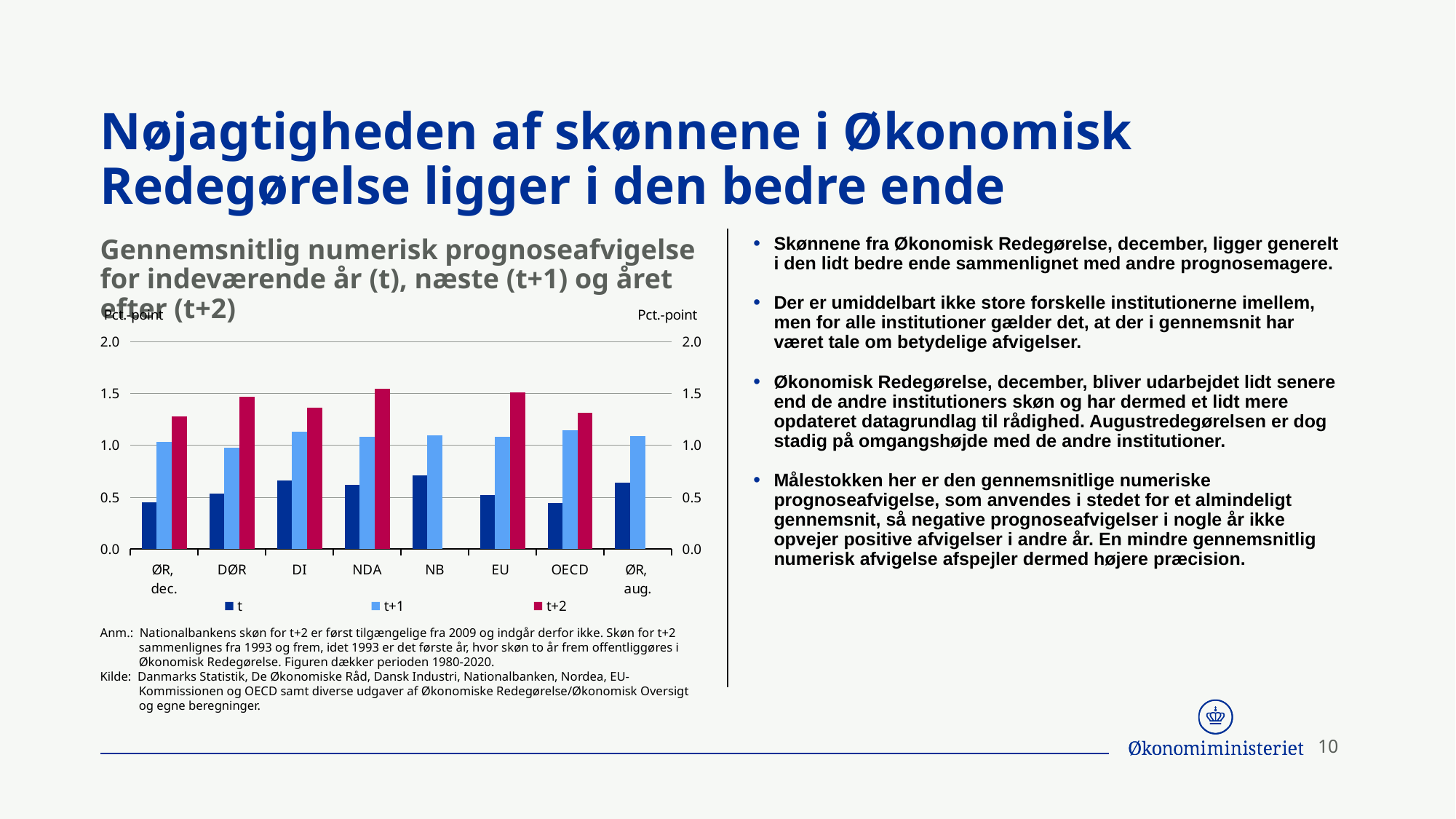
Is the value for the t+2 series for ØR, dec. greater or less than 1.5? less Which category has the lowest value for the t+1 series? DØR How many categories are shown along the x axis of the chart? 8 Is the value for the t series for NB greater or less than 0.5? greater Is the value for the t series for ØR, dec. greater or less than 0.5? less How many series does the chart legend list? 3 What kind of chart is shown on the slide? bar chart Which is larger: the t value for DI or the t value for OECD? DI What unit is shown on the chart's y axis? Pct.-point Which is larger: the t+2 value for DØR or the t+2 value for ØR, dec.? DØR